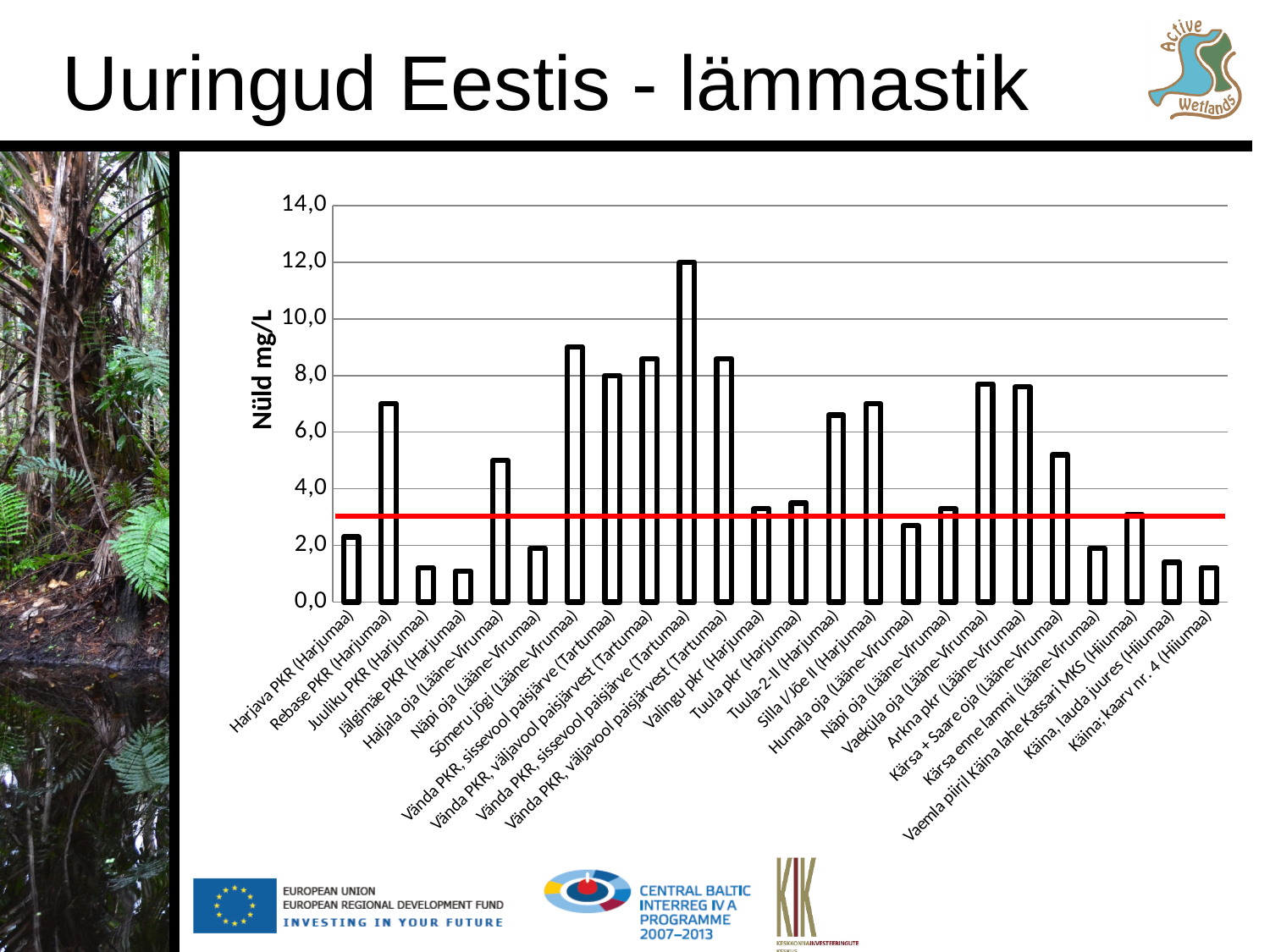
Is the highest bar in the chart greater or less than 10,0? greater What is the label of the vertical axis of the chart? Nüld mg/L Is the value for Harjava PKR (Harjumaa) greater or less than 4,0? less Is the value for Sõmeru jõgi (Lääne-Virumaa) greater or less than 8,0? greater What colour is the horizontal reference line drawn across the chart? red Which sampling site has the highest bar in the chart? Vända PKR, sissevool paisjärve (Tartumaa) Which has the larger value, Vaeküla oja (Lääne-Virumaa) or Humala oja (Lääne-Virumaa)? Vaeküla oja (Lääne-Virumaa) What kind of chart is shown on the slide? bar chart How many bars (sampling sites) are plotted in the chart? 24 Which has the larger value, Rebase PKR (Harjumaa) or Juuliku PKR (Harjumaa)? Rebase PKR (Harjumaa)